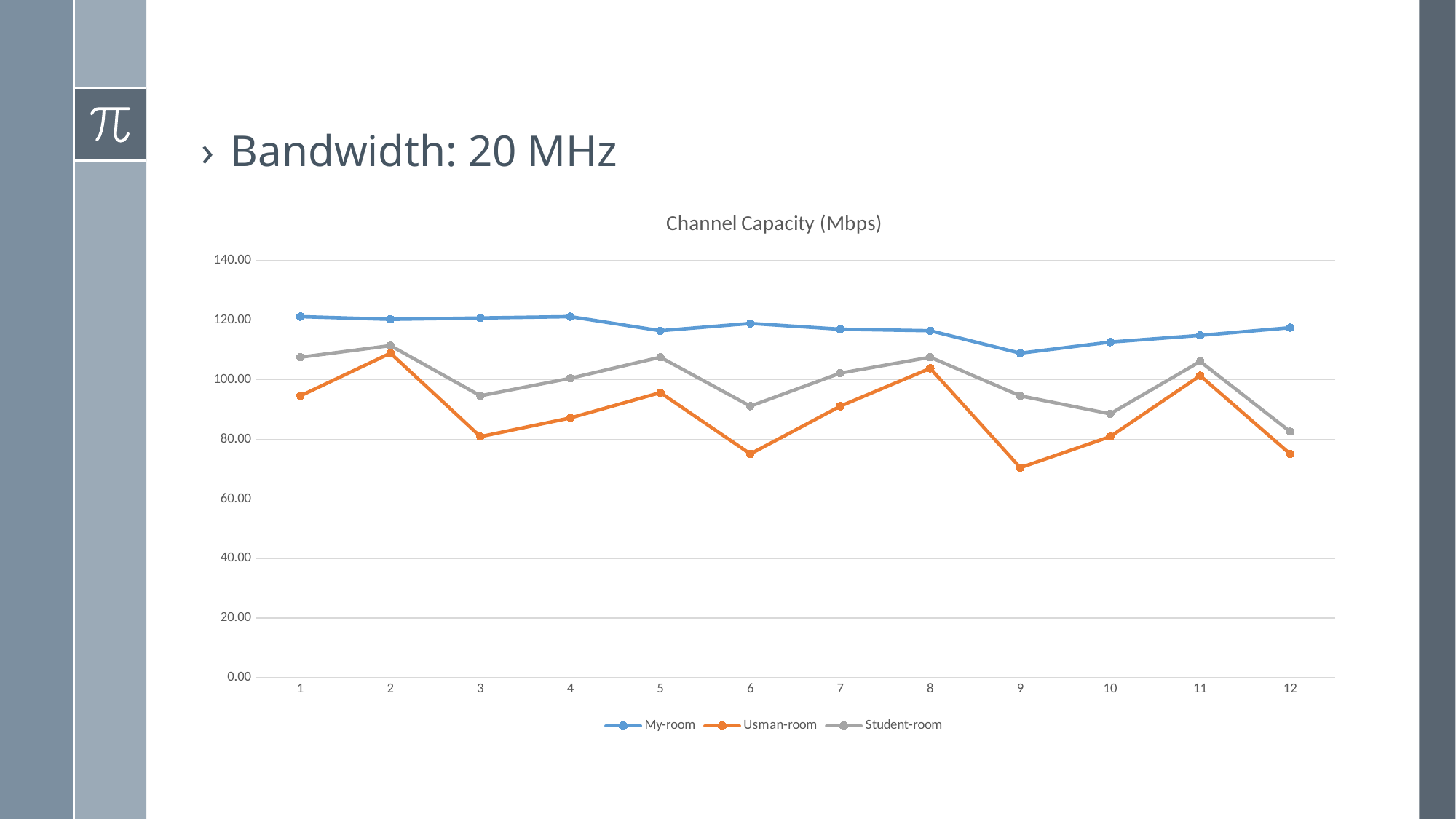
How many series does the legend list? 3 Is the value for Usman-room at point 9 greater or less than 80? less At which point does the Usman-room series reach its highest value? 2 What kind of chart is shown on the slide? line chart Is the value for Student-room at point 2 greater or less than 100? greater What is the title of the chart? Channel Capacity (Mbps) How many points are plotted along the x axis for each series? 12 Which series is plotted in orange? Usman-room At point 12, which series has the larger value, Usman-room or Student-room? Student-room Is the value for My-room at point 9 greater or less than 120? less At which point does the Usman-room series reach its lowest value? 9 At point 3, which series has the larger value, My-room or Usman-room? My-room